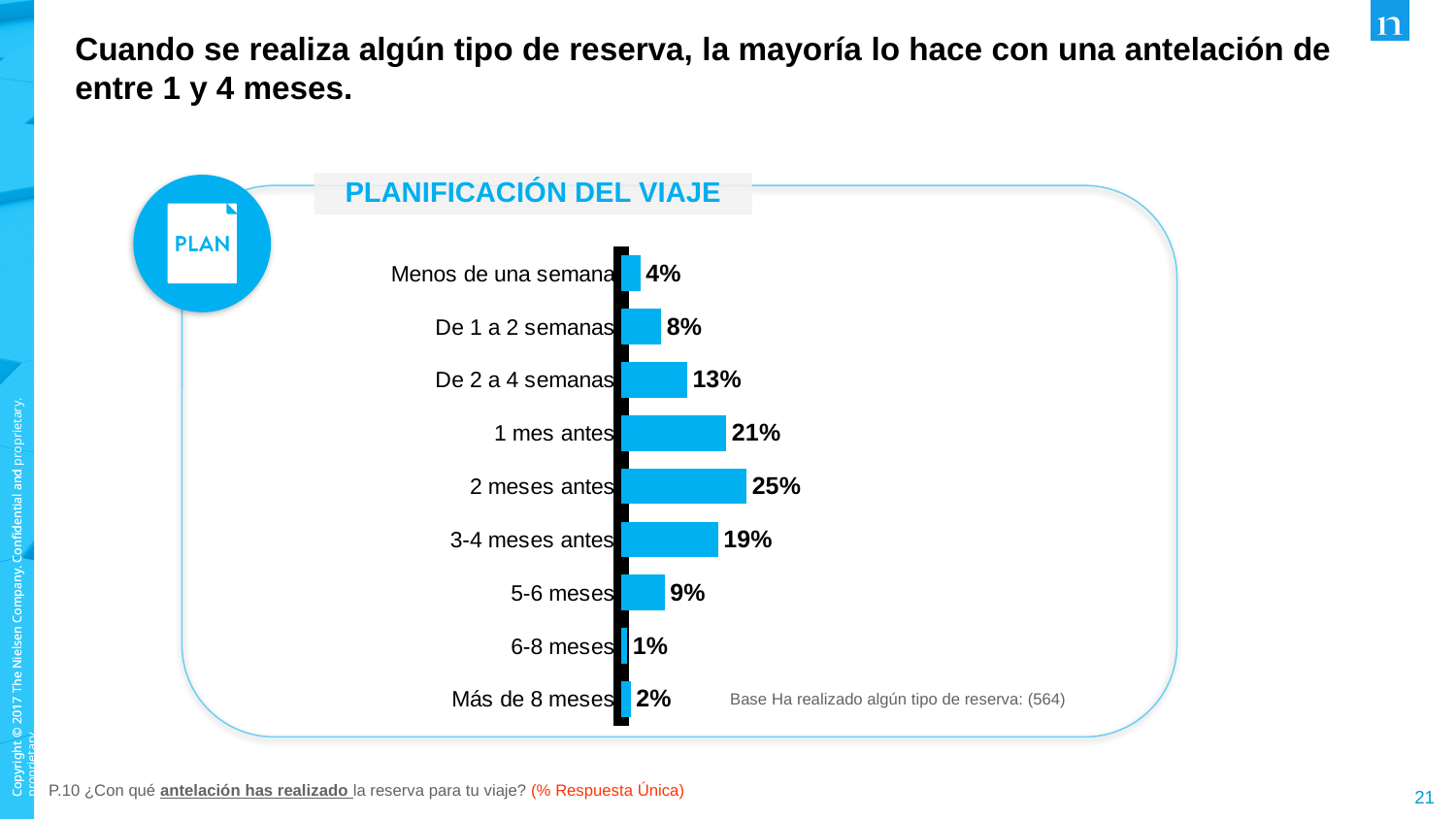
What is the title of the chart? PLANIFICACIÓN DEL VIAJE Which category has the highest value? 2 meses antes What is the base size stated for the chart? 564 What kind of chart is shown on the slide? Bar chart How many categories are shown in the chart? 9 What is the value for "2 meses antes"? 25% Which category has the lowest value? 6-8 meses What is the difference between "2 meses antes" and "Menos de una semana"? 21% What is the difference between "1 mes antes" and "3-4 meses antes"? 2% What is the value for "5-6 meses"? 9% What is the value for "De 2 a 4 semanas"? 13% Which is larger, "De 1 a 2 semanas" or "5-6 meses"? 5-6 meses